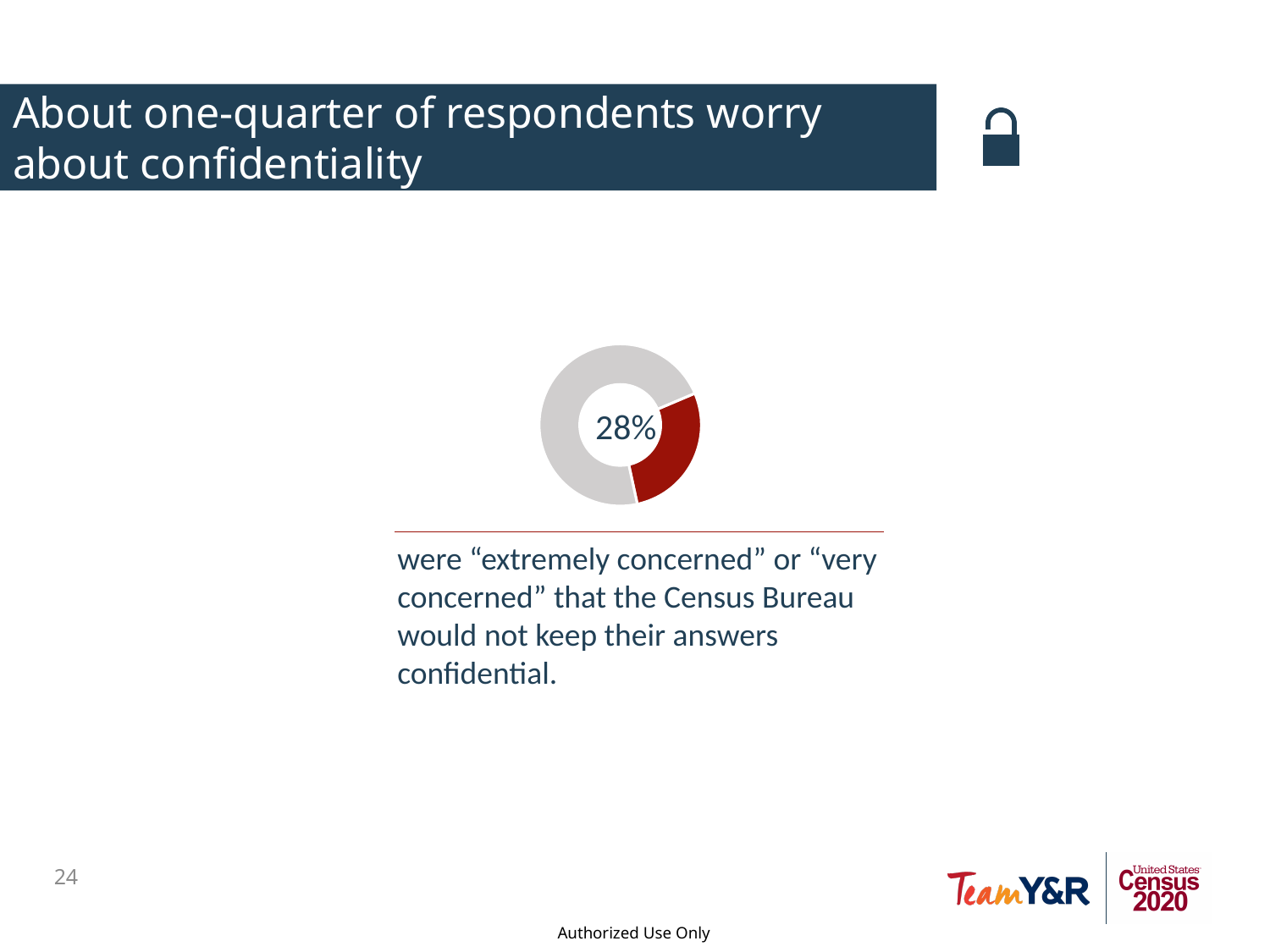
Is the red slice of the donut chart greater or less than 50% of the whole? less What is the title of the slide containing the donut chart? About one-quarter of respondents worry about confidentiality Which slice of the donut chart is larger, the red slice or the grey slice? the grey slice What colour is the highlighted slice representing the 28% of concerned respondents? red What kind of chart is shown on the slide? donut chart What percentage is printed in the center of the donut chart? 28% How many slices does the donut chart have? 2 What share of the donut chart is taken up by the grey (non-highlighted) slice? 72% What percentage of respondents were "extremely concerned" or "very concerned" that the Census Bureau would not keep their answers confidential? 28%